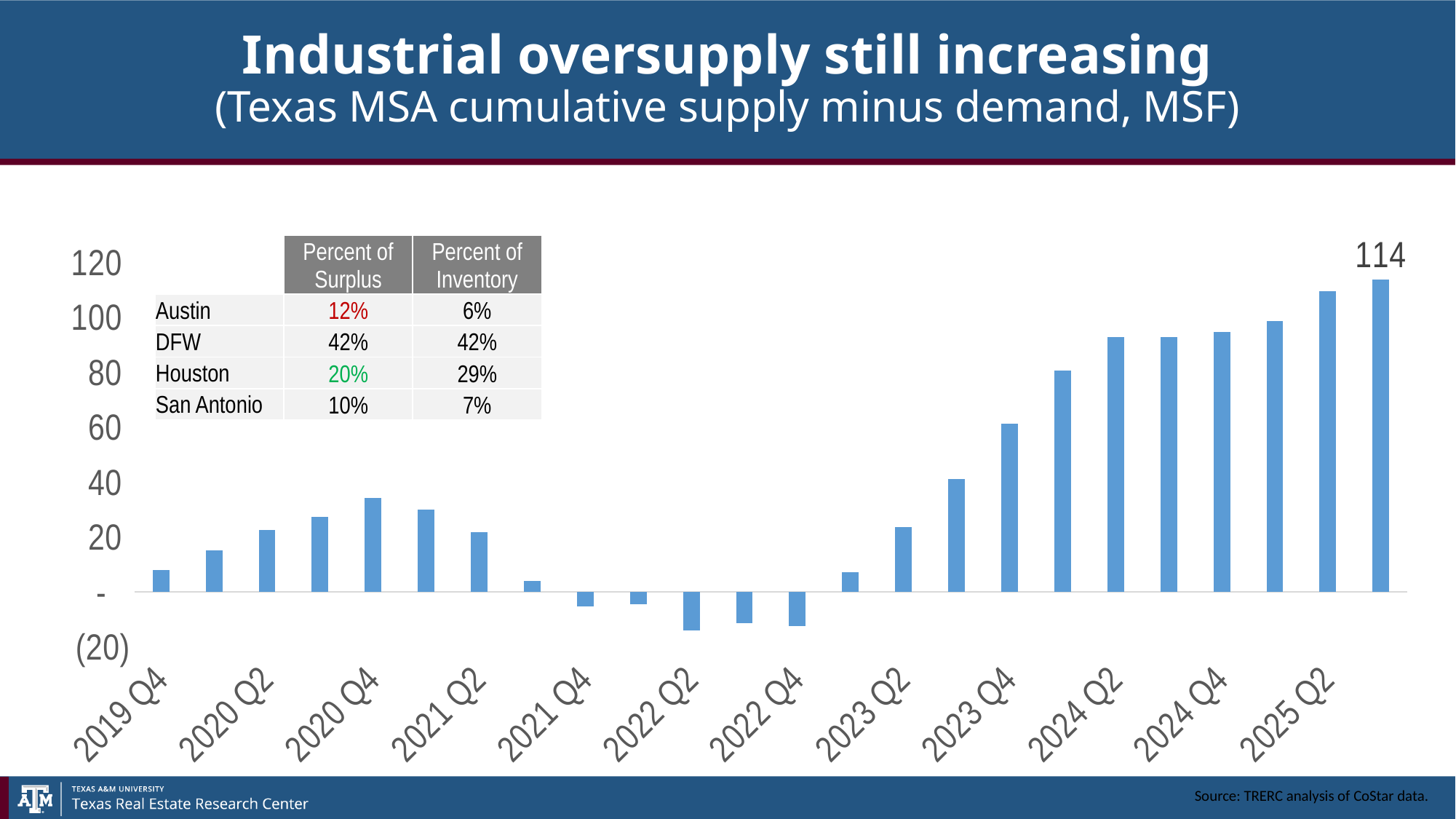
What is the main title of the slide? Industrial oversupply still increasing Is the value for 2023 Q2 greater or less than 40? less What is the value printed on the tallest bar in the chart? 114 Which bar in the chart is the highest? the last bar (114) What type of chart is shown on the slide? bar chart How many quarter labels are shown on the x axis? 12 Is the value for 2020 Q4 greater or less than 20? greater Do the values rise or fall from 2023 Q2 to 2025 Q2? rise Is the value for 2024 Q2 greater or less than 80? greater Which is larger, the value for 2020 Q4 or the value for 2021 Q2? 2020 Q4